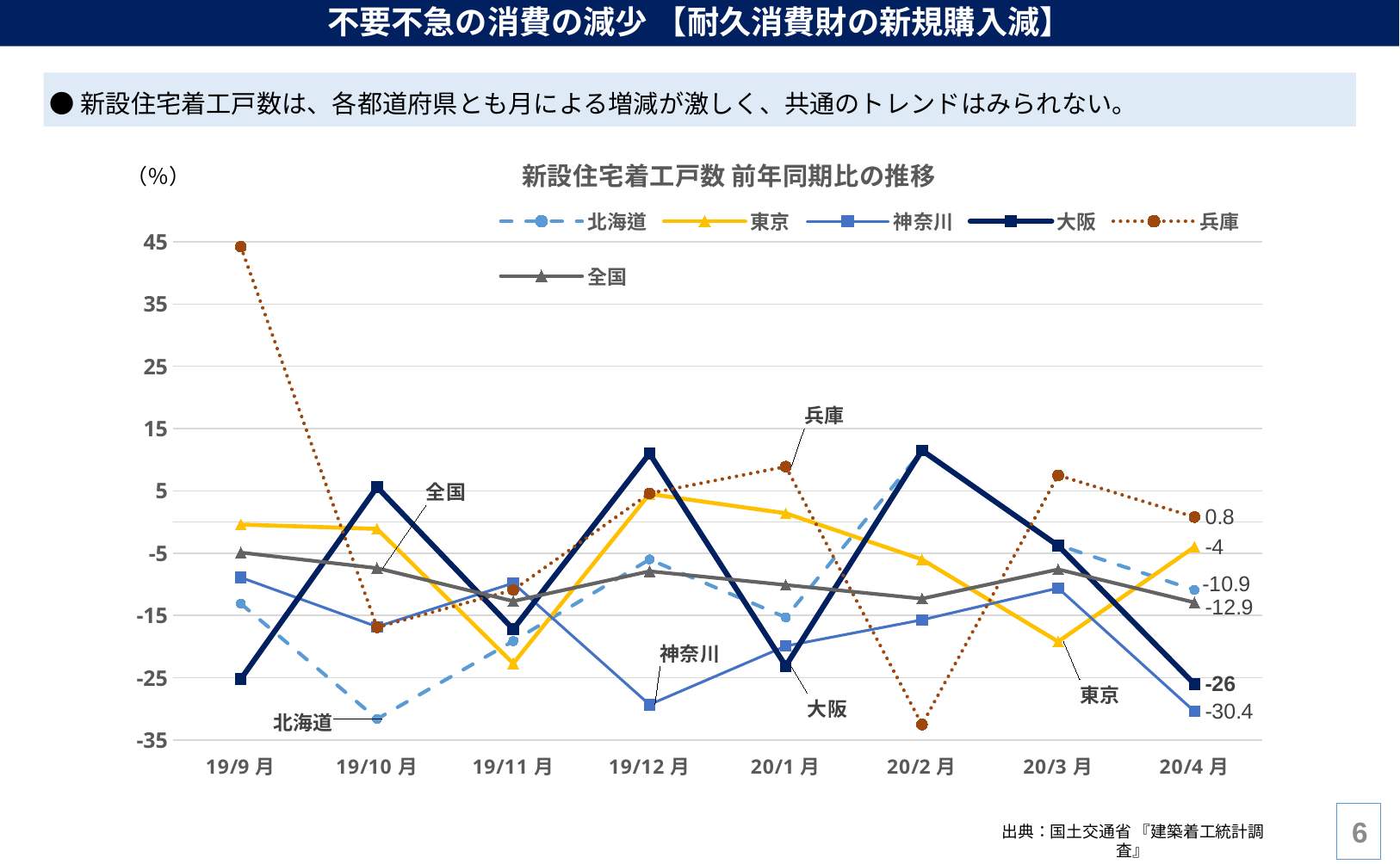
How many series does the legend of the chart list? 6 Which series has the lowest value in 20/4月? 神奈川 Is the value for 兵庫 in 19/9月 greater or less than 35? greater What is the title of the chart? 新設住宅着工戸数 前年同期比の推移 What is the value for 兵庫 in 20/4月? 0.8 What is the value for 大阪 in 20/4月? -26 What kind of chart is shown on the slide? line chart In 20/4月, which is larger, the value for 北海道 or the value for 全国? 北海道 What is the value for 神奈川 in 20/4月? -30.4 Which series has the highest value in 20/4月? 兵庫 How many months are shown along the x axis of the chart? 8 What is the difference between the values for 東京 and 大阪 in 20/4月? 22